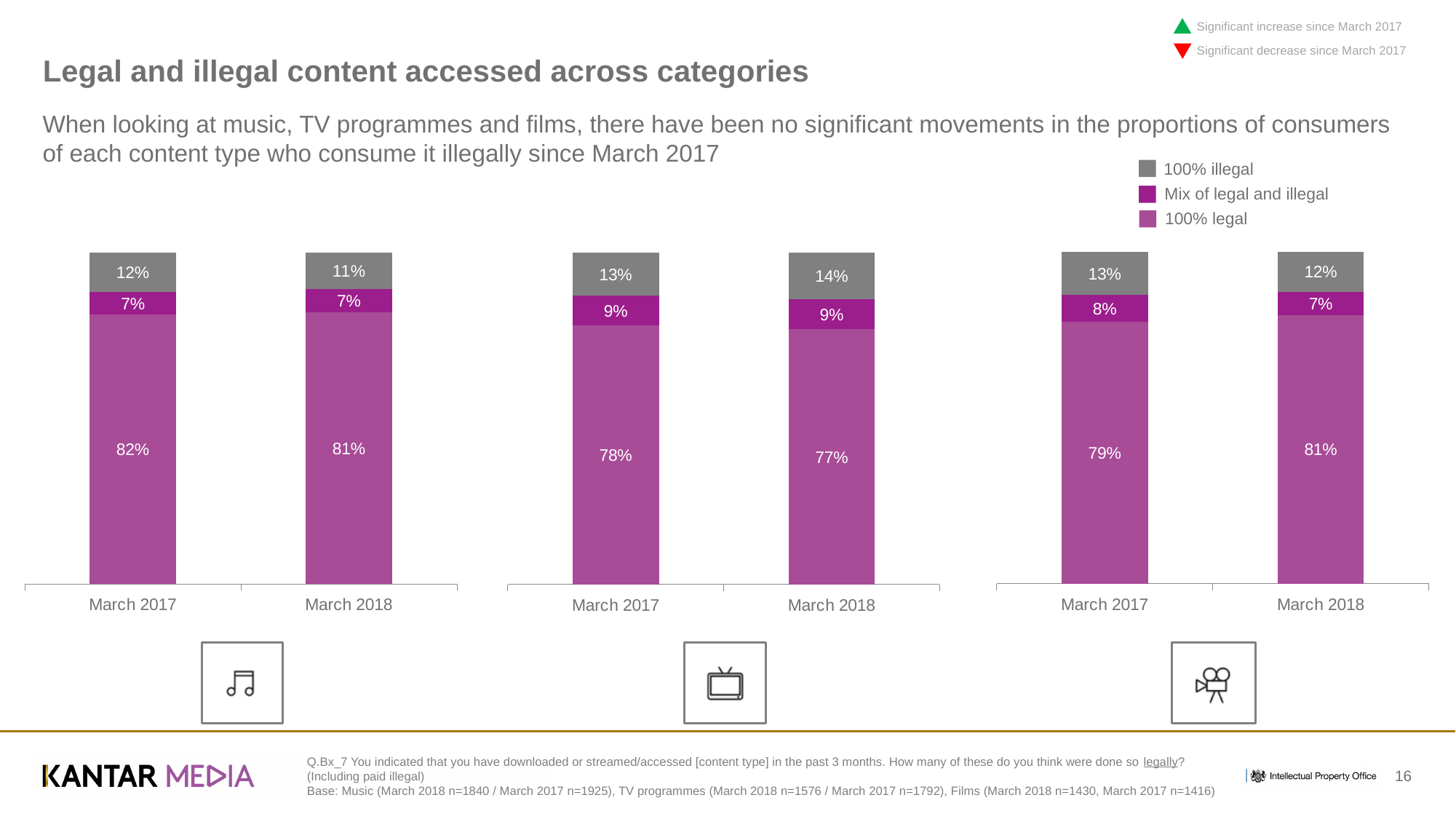
How many series does the legend list? 3 What kind of chart is the left chart? Stacked bar chart In the left chart, which period has the higher 100% illegal value? March 2017 Which legend entry is shown in grey? 100% illegal In the middle chart, what is the difference between the 100% legal values for March 2017 and March 2018? 1% In the right chart, what is the value for 100% illegal in March 2017? 13% How many categories are shown on the x axis of the middle chart? 2 In the left chart, what is the value for 100% illegal in March 2018? 11% In the middle chart, what is the value for Mix of legal and illegal in March 2018? 9% In the right chart, what is the value for 100% legal in March 2018? 81% In the left chart, what is the value for 100% legal in March 2017? 82% In the right chart, which is larger: the 100% legal value for March 2017 or for March 2018? March 2018